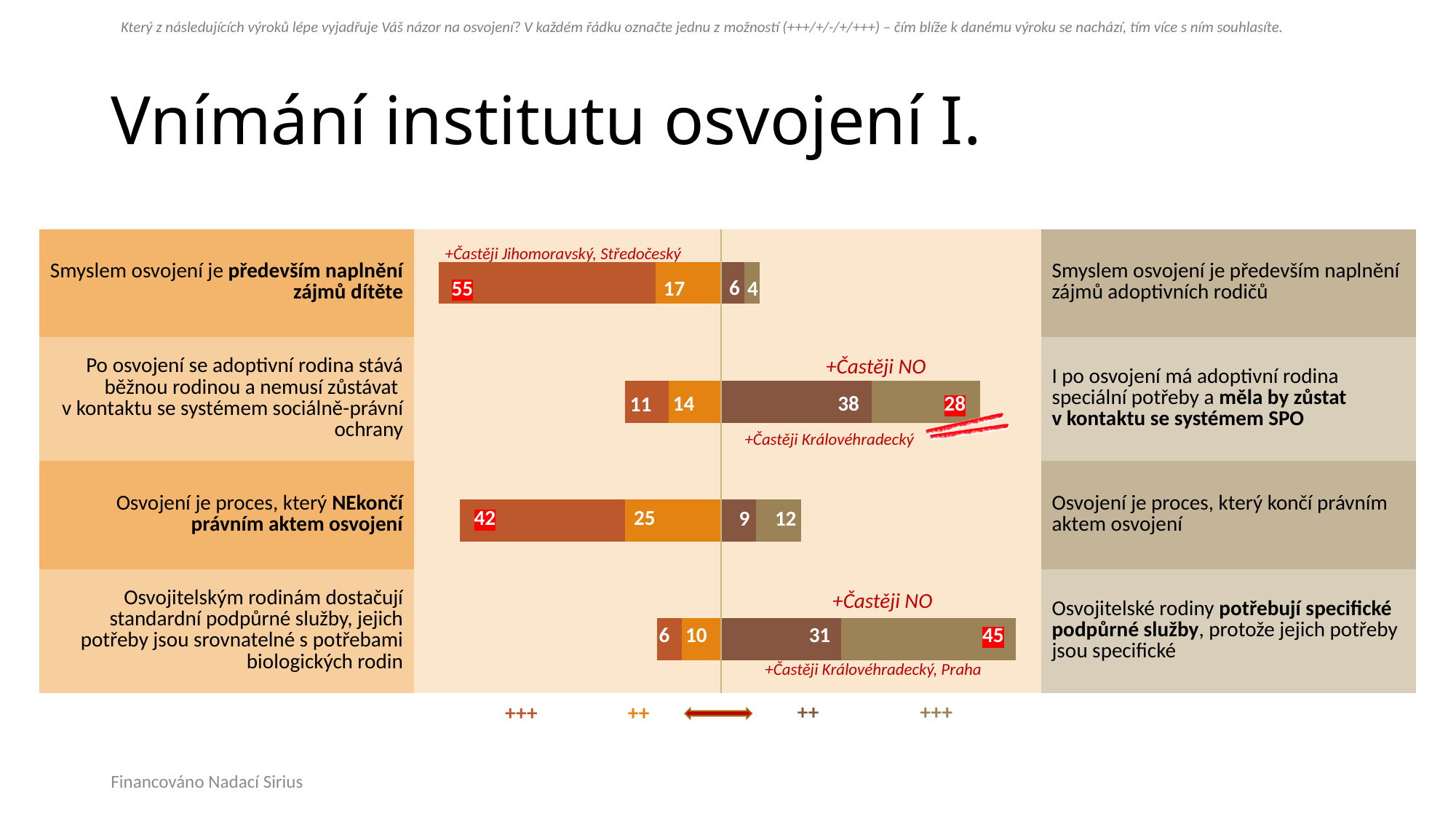
What is the value of the orange (++) segment in the row "Osvojení je proces, který NEkončí právním aktem osvojení"? 25 In the row "Osvojení je proces, který NEkončí právním aktem osvojení", which is larger: the leftmost segment or the rightmost segment? The leftmost segment (42) How many pairs of opposing statements (rows) does the chart show? 4 Which segment value is the largest in the entire chart? 55 What red annotation is written above the bar in the first row? +Častěji Jihomoravský, Středočeský What is the total of all four segments in the bar for the last row ("Osvojitelské rodiny potřebují specifické podpůrné služby")? 92 What is the value of the strongest-agreement (+++) segment for the statement "Smyslem osvojení je především naplnění zájmů dítěte"? 55 In the first row, what is the difference between the leftmost segment (55) and the rightmost segment (4)? 51 What is the value of the rightmost (+++) segment for the statement "Osvojitelské rodiny potřebují specifické podpůrné služby"? 45 What kind of chart is shown on the slide? Bar chart (diverging stacked bar chart) In the row "I po osvojení má adoptivní rodina speciální potřeby a měla by zůstat v kontaktu se systémem SPO", what is the value of the brown (++) segment on the right side? 38 What is the total of all four segments in the bar for the first row ("Smyslem osvojení je především naplnění zájmů dítěte")? 82